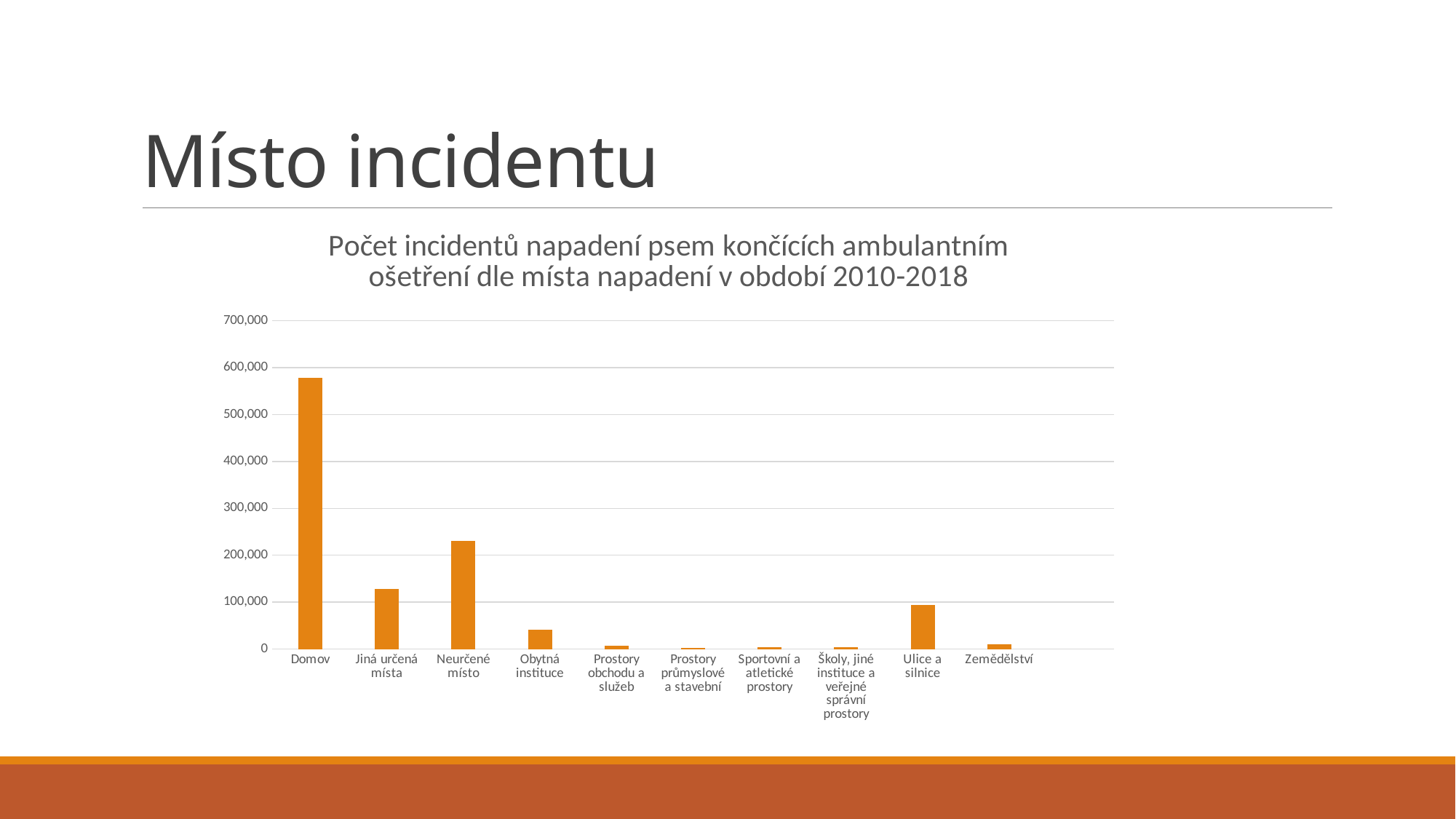
Is the value for Jiná určená místa greater or less than 100,000? greater Which is larger, the value for Neurčené místo or the value for Jiná určená místa? Neurčené místo What is the title of the chart? Počet incidentů napadení psem končících ambulantním ošetření dle místa napadení v období 2010-2018 Which category has the highest value in the chart? Domov What type of chart is shown on the slide? bar chart How many categories are shown on the x axis of the chart? 10 Is the value for Domov greater or less than 500,000? greater Is the value for Obytná instituce greater or less than 100,000? less Which is larger, the value for Obytná instituce or the value for Zemědělství? Obytná instituce Which is larger, the value for Jiná určená místa or the value for Ulice a silnice? Jiná určená místa